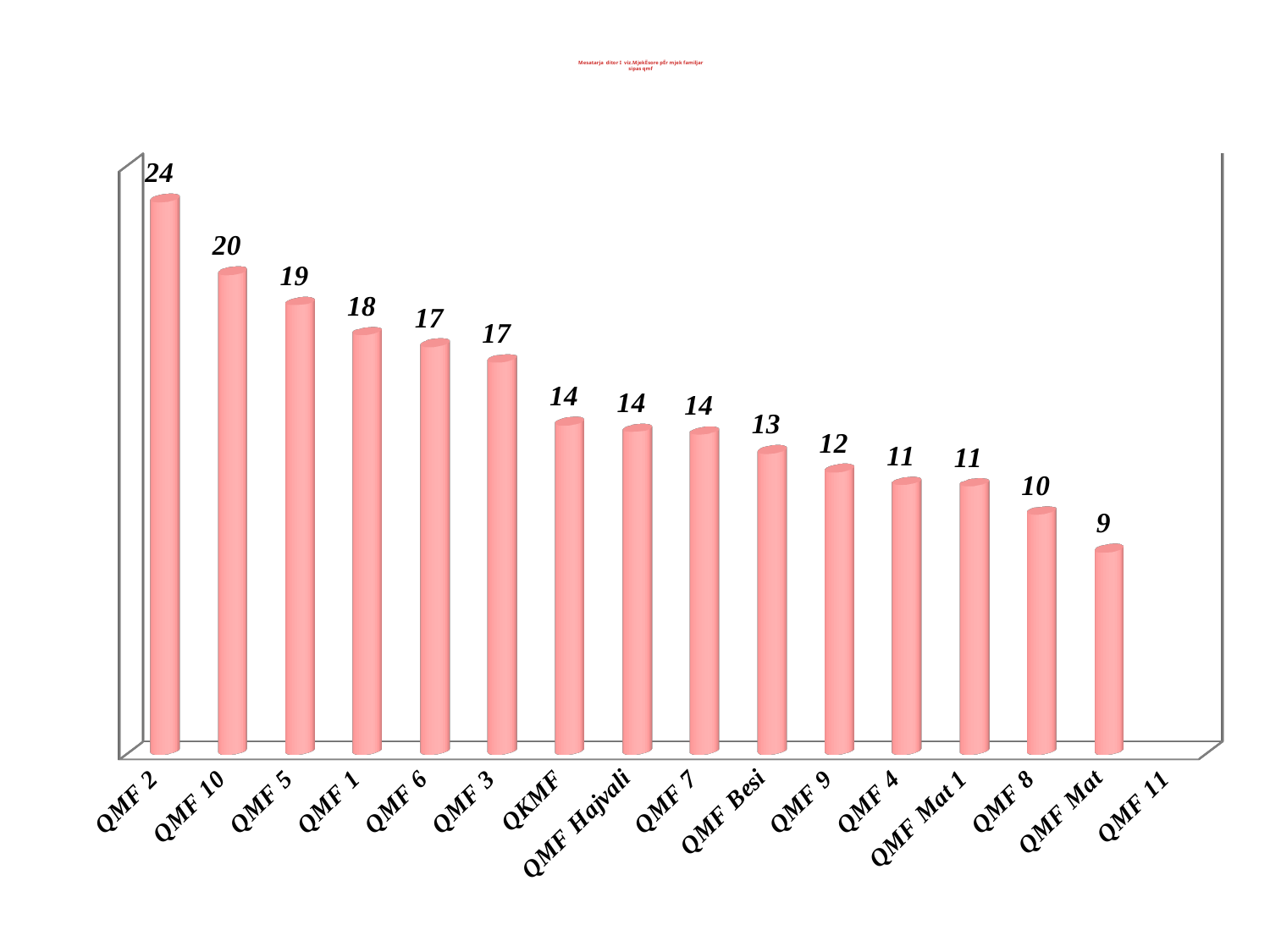
What is the value for QMF Mat 1? 11 Which category has the lowest value among the bars shown? QMF Mat Do the values rise or fall from left to right along the x axis? fall Which category has the highest value? QMF 2 How many bars are plotted on the chart? 15 What is the value for QMF 2? 24 Which is larger, the value for QMF 1 or the value for QMF 9? QMF 1 What is the value for QMF Hajvali? 14 What is the difference between the values for QMF 5 and QMF Mat? 10 What is the difference between the values for QMF 2 and QMF 10? 4 What kind of chart is shown on the slide? bar chart What is the value for QMF Besi? 13